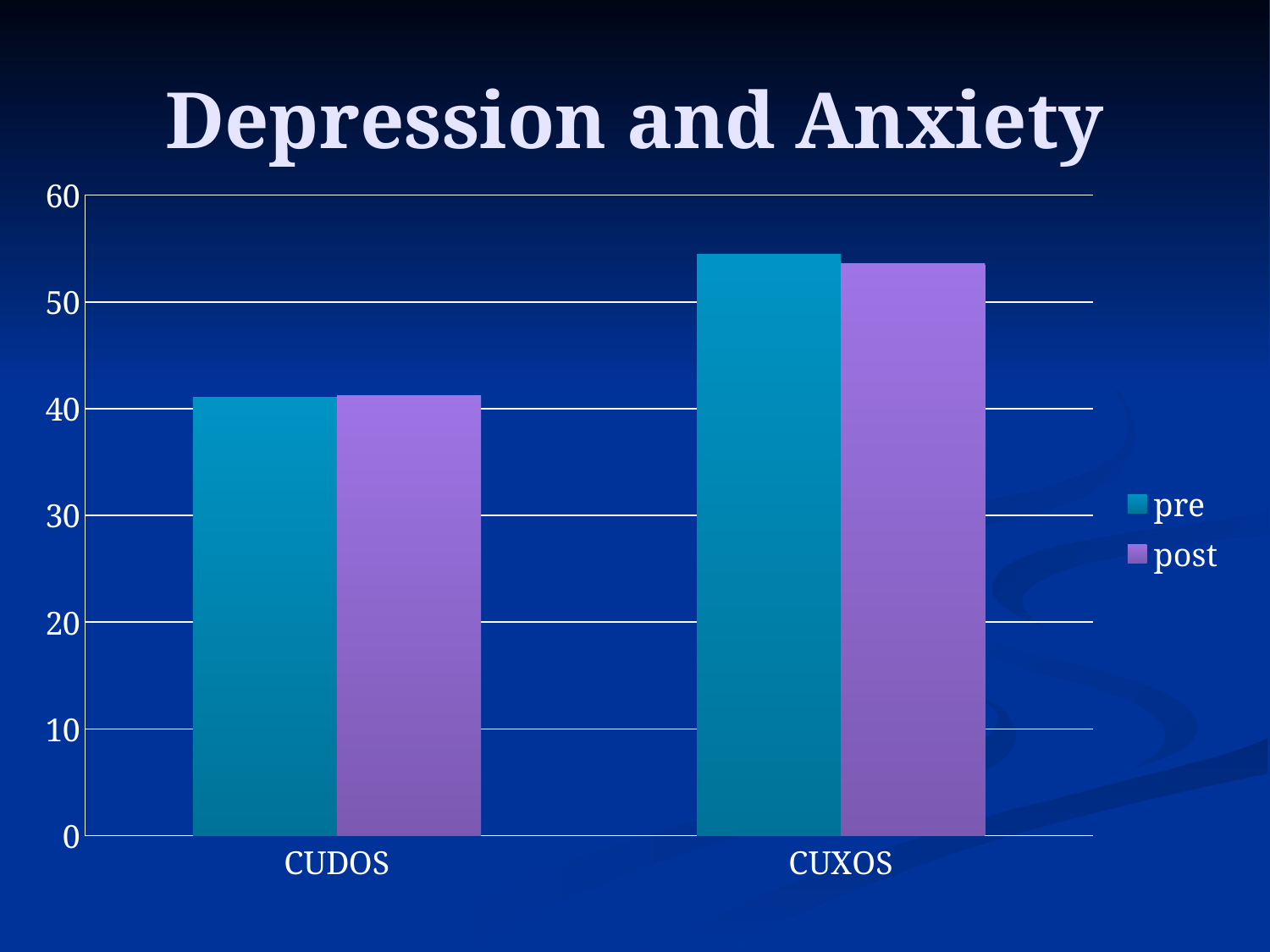
Which category has the higher pre value, CUDOS or CUXOS? CUXOS How many categories are shown on the x axis? 2 Is the pre value for CUDOS greater or less than 50? less Is the pre value for CUXOS greater or less than 50? greater Which category has the lower post value? CUDOS Which category has the higher post value? CUXOS What kind of chart is shown on the slide? bar chart Is the post value for CUXOS greater or less than 50? greater How many series does the legend list? 2 What is the title of the chart? Depression and Anxiety What are the two series named in the legend? pre and post